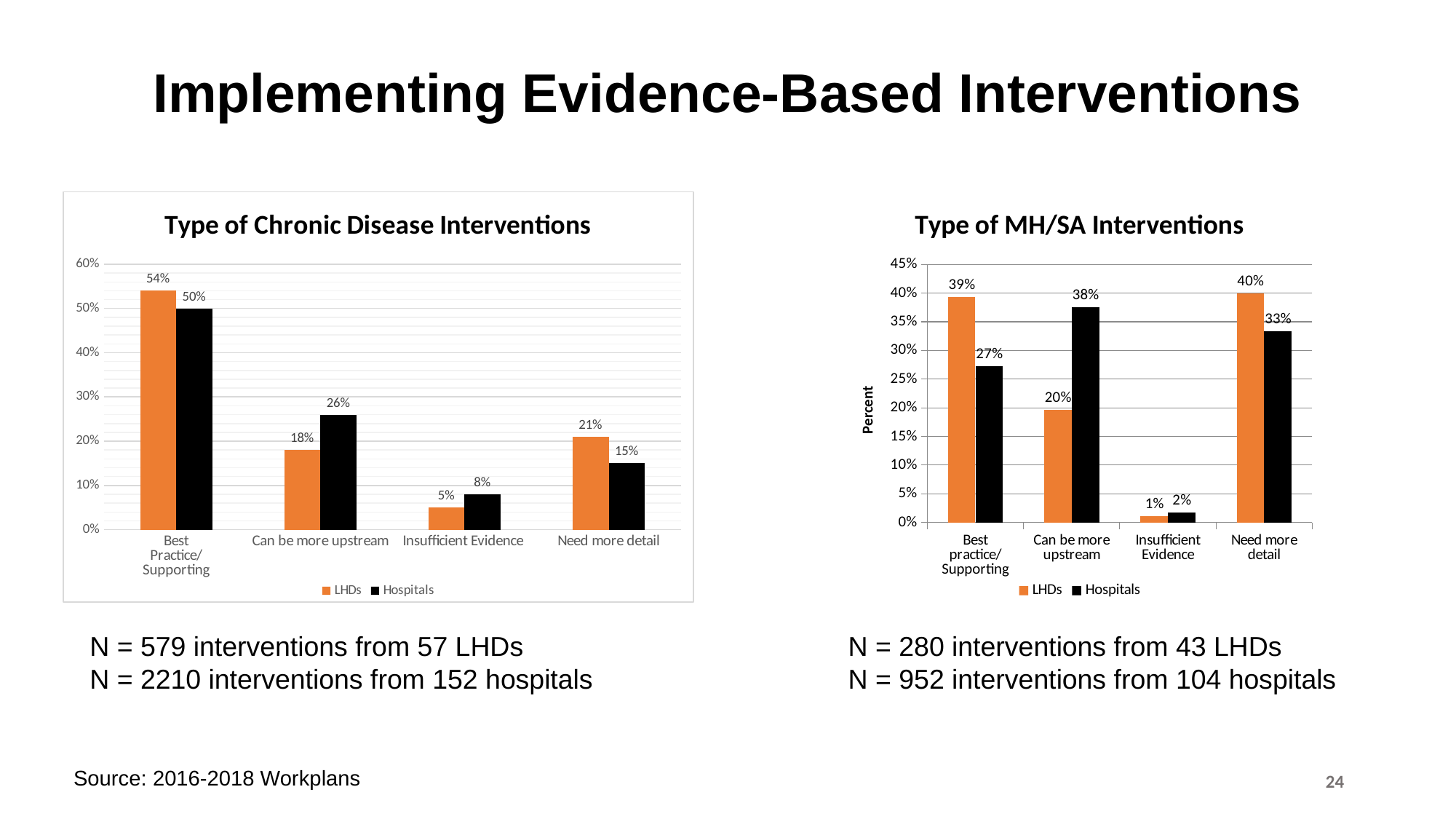
In the 'Type of Chronic Disease Interventions' chart, what is the value for LHDs in the Best Practice/Supporting category? 54% In the 'Type of MH/SA Interventions' chart, which category has the highest value for LHDs? Need more detail In the 'Type of Chronic Disease Interventions' chart, which category has the lowest value for Hospitals? Insufficient Evidence In the 'Type of Chronic Disease Interventions' chart, what is the value for Hospitals in the Can be more upstream category? 26% In the 'Type of Chronic Disease Interventions' chart, what is the difference between the LHDs and Hospitals values for Need more detail? 6% What kind of chart is the 'Type of MH/SA Interventions' chart? Bar chart In the 'Type of MH/SA Interventions' chart, which is larger for Best practice/Supporting: LHDs or Hospitals? LHDs How many series does the legend of the 'Type of MH/SA Interventions' chart list? 2 In the 'Type of MH/SA Interventions' chart, what is the difference between the Hospitals and LHDs values for Can be more upstream? 18% In the 'Type of MH/SA Interventions' chart, what is the value for Hospitals in the Need more detail category? 33% In the 'Type of Chronic Disease Interventions' chart, which colour represents Hospitals? Black How many categories are shown on the x axis of the 'Type of Chronic Disease Interventions' chart? 4